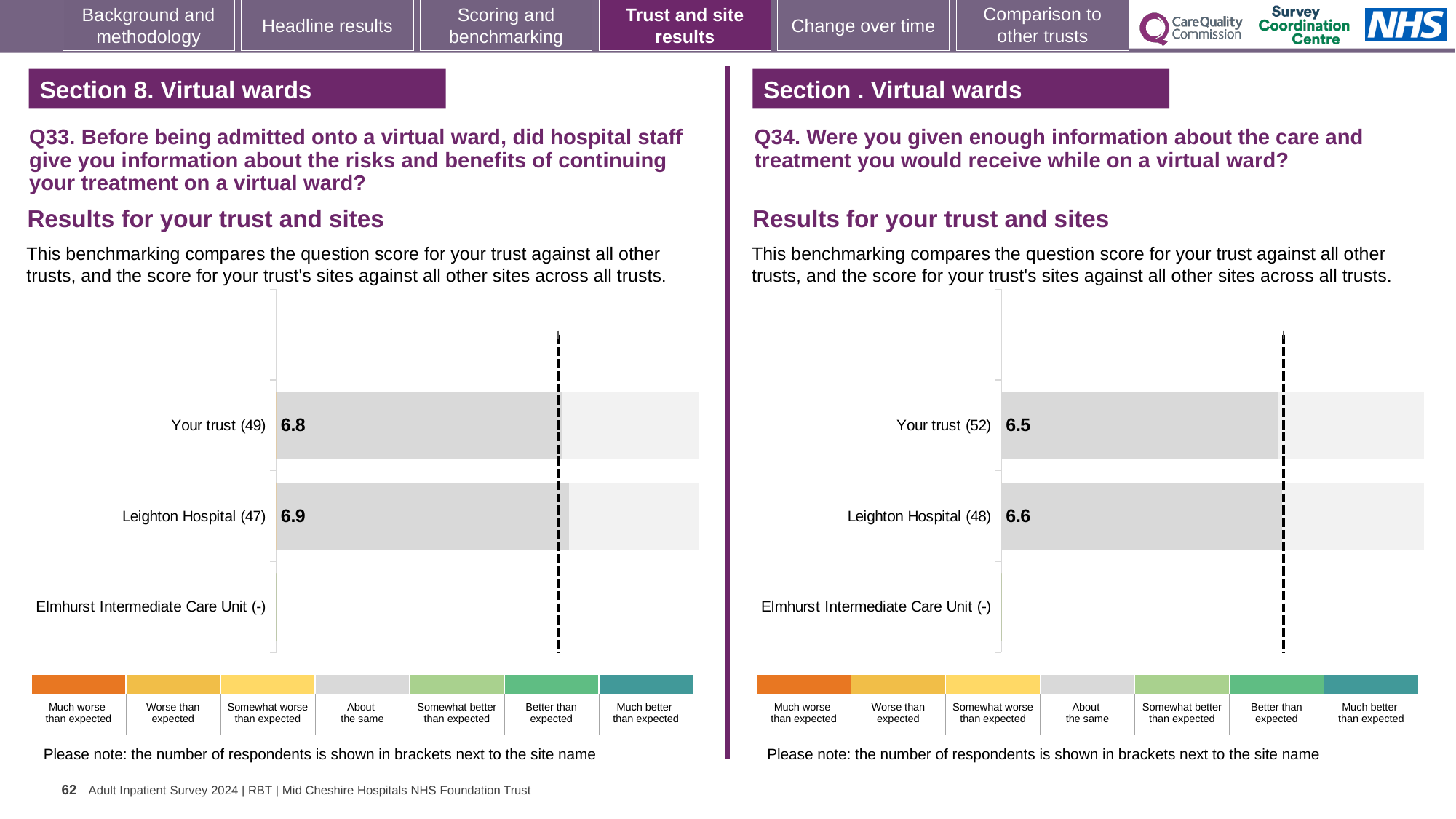
In the Q34 chart on the right, how many respondents are shown in brackets for Leighton Hospital? 48 In the Q34 chart on the right, what is the difference between the Leighton Hospital score and the Your trust score? 0.1 In the Q33 chart on the left, what is the score for Your trust? 6.8 In the Q33 chart on the left, what is the score for Leighton Hospital? 6.9 In the Q33 chart on the left, which category has no score shown? Elmhurst Intermediate Care Unit What kind of chart is the Q34 chart on the right? Bar chart In the Q34 chart on the right, which has the lower score, Your trust or Leighton Hospital? Your trust How many categories are listed on the vertical axis of the Q33 chart on the left? 3 In the Q34 chart on the right, what is the score for Your trust? 6.5 In the Q33 chart on the left, which has the higher score, Your trust or Leighton Hospital? Leighton Hospital In the Q34 chart on the right, what is the score for Leighton Hospital? 6.6 In the Q33 chart on the left, how many respondents are shown in brackets for Your trust? 49